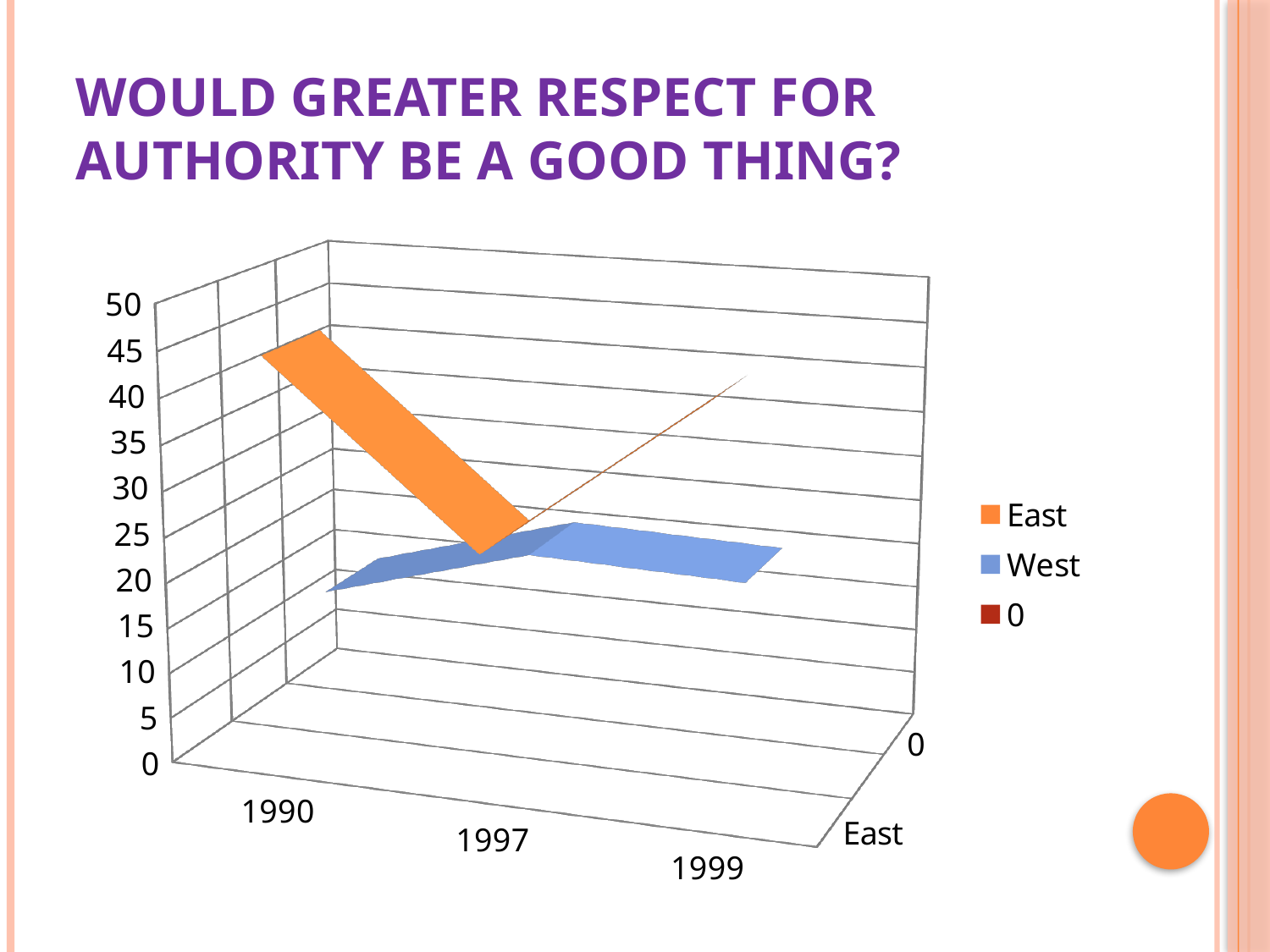
How many years are shown on the x axis? 3 What is the title of the chart? Would greater respect for authority be a good thing? How many series does the legend list? 3 What is the highest value shown on the vertical axis? 50 Which is larger in 1990, East or West? East Is the value for West in 1990 greater or less than 40? less Which years are shown on the x axis? 1990, 1997, 1999 Is the value for East in 1990 greater or less than 30? greater Does the East series rise or fall from 1990 to 1997? fall